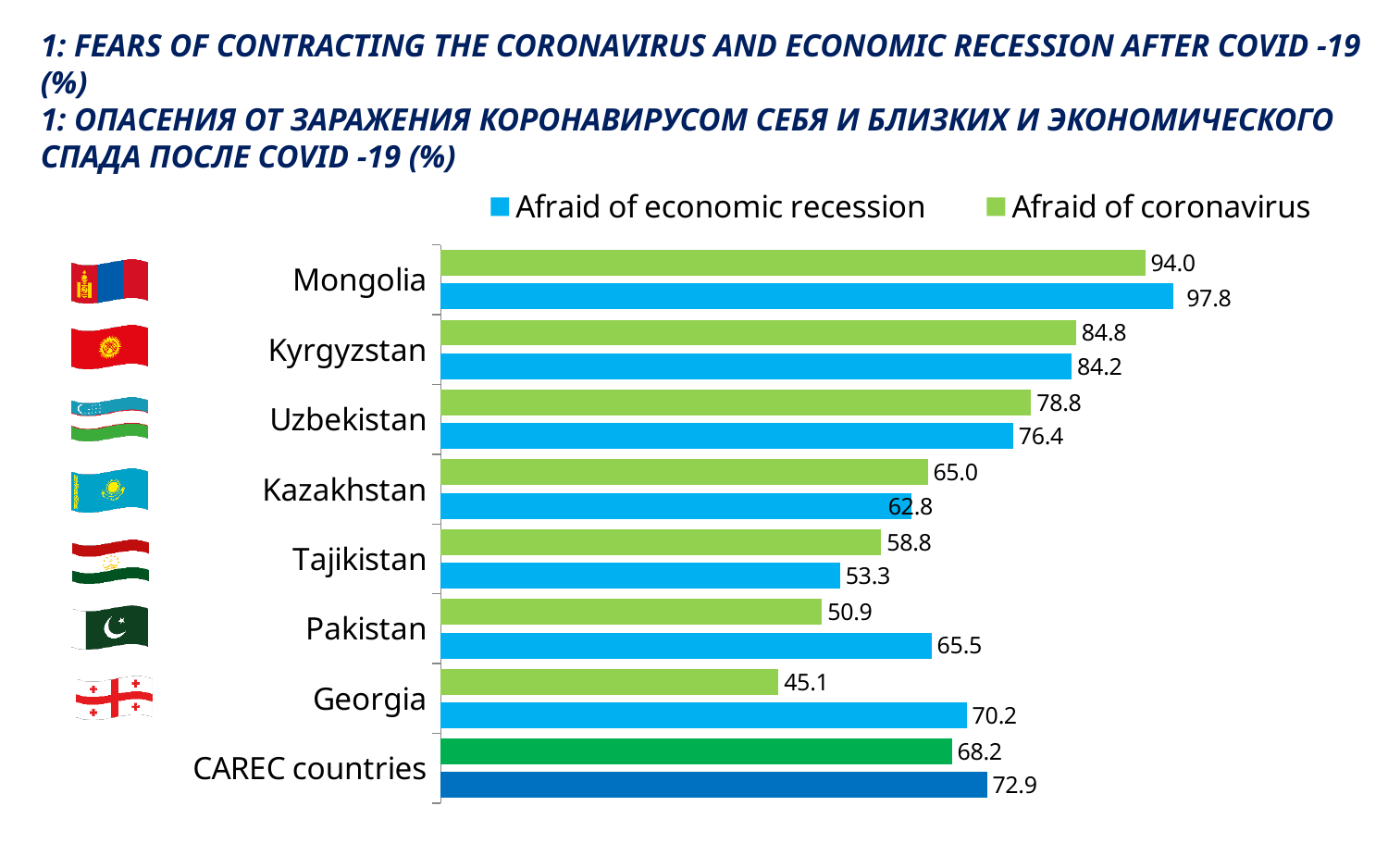
Which colour represents 'Afraid of coronavirus' in the legend? Green How many categories are shown on the chart? 8 What is the value for 'Afraid of economic recession' for CAREC countries? 72.9 Which category has the lowest value for 'Afraid of coronavirus'? Georgia What kind of chart is shown on the slide? Bar chart What is the difference between Mongolia's and Kyrgyzstan's 'Afraid of economic recession' values? 13.6 What is the difference between the 'Afraid of economic recession' and 'Afraid of coronavirus' values for Pakistan? 14.6 For Tajikistan, which is larger: 'Afraid of coronavirus' or 'Afraid of economic recession'? Afraid of coronavirus How many series does the legend list? 2 Which category has the highest value for 'Afraid of economic recession'? Mongolia What is the value for 'Afraid of coronavirus' for Mongolia? 94.0 What is the value for 'Afraid of economic recession' for Georgia? 70.2